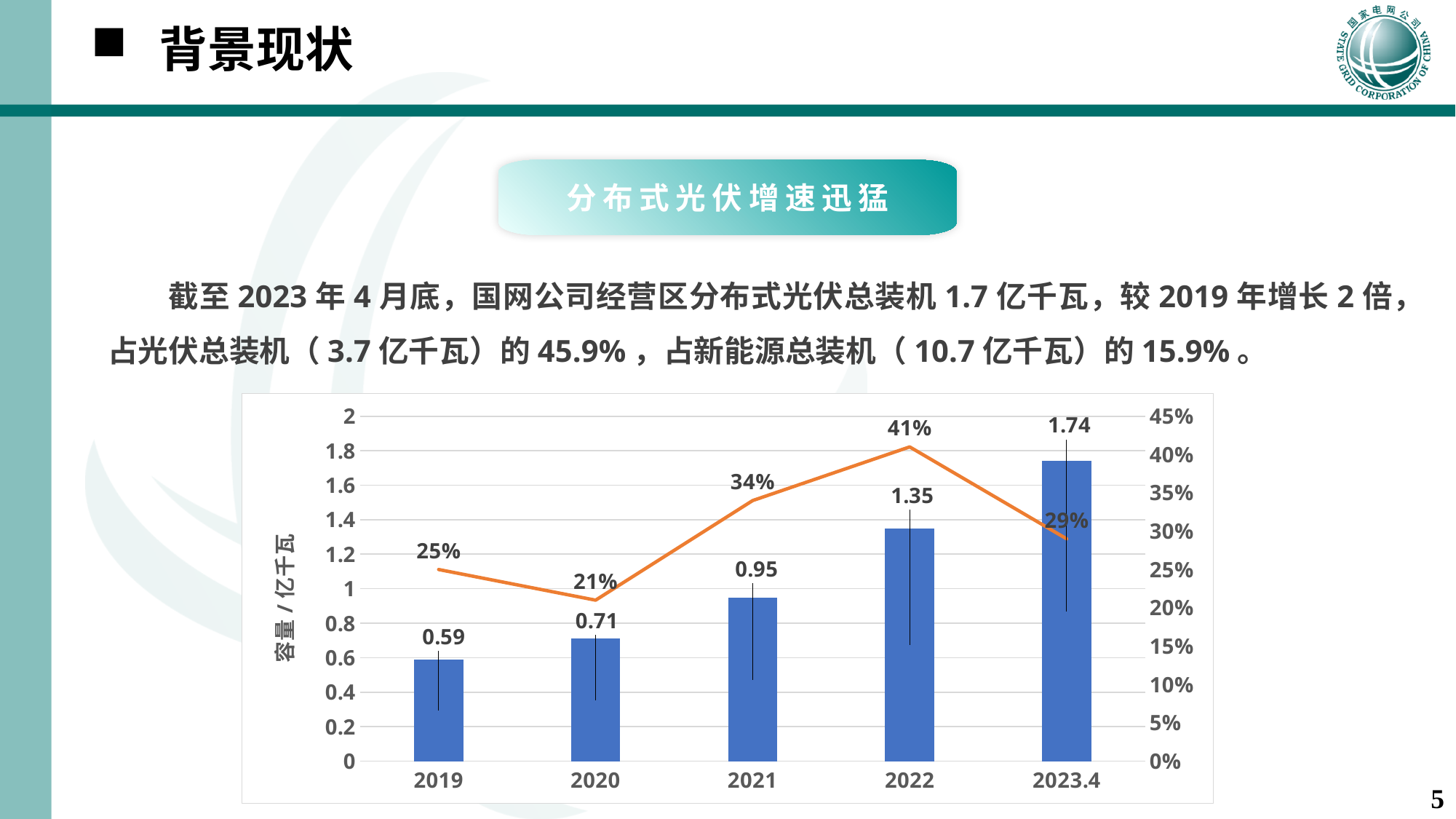
What is the difference in capacity between 2022 and 2019? 0.76 What is the label of the left vertical axis? 容量 / 亿千瓦 What is the capacity (容量) value shown for 2021? 0.95 How many years are shown on the x axis? 5 What is the capacity value shown for 2023.4? 1.74 Do the capacity bars rise or fall from 2019 to 2023.4? rise Which year has the highest capacity bar? 2023.4 What percentage does the line show for 2022? 41% Which year has the lowest percentage on the line? 2020 What kind of chart is shown on the slide? combined bar and line chart Which is larger, the percentage for 2021 or the percentage for 2023.4? 2021 What percentage does the line show for 2020? 21%